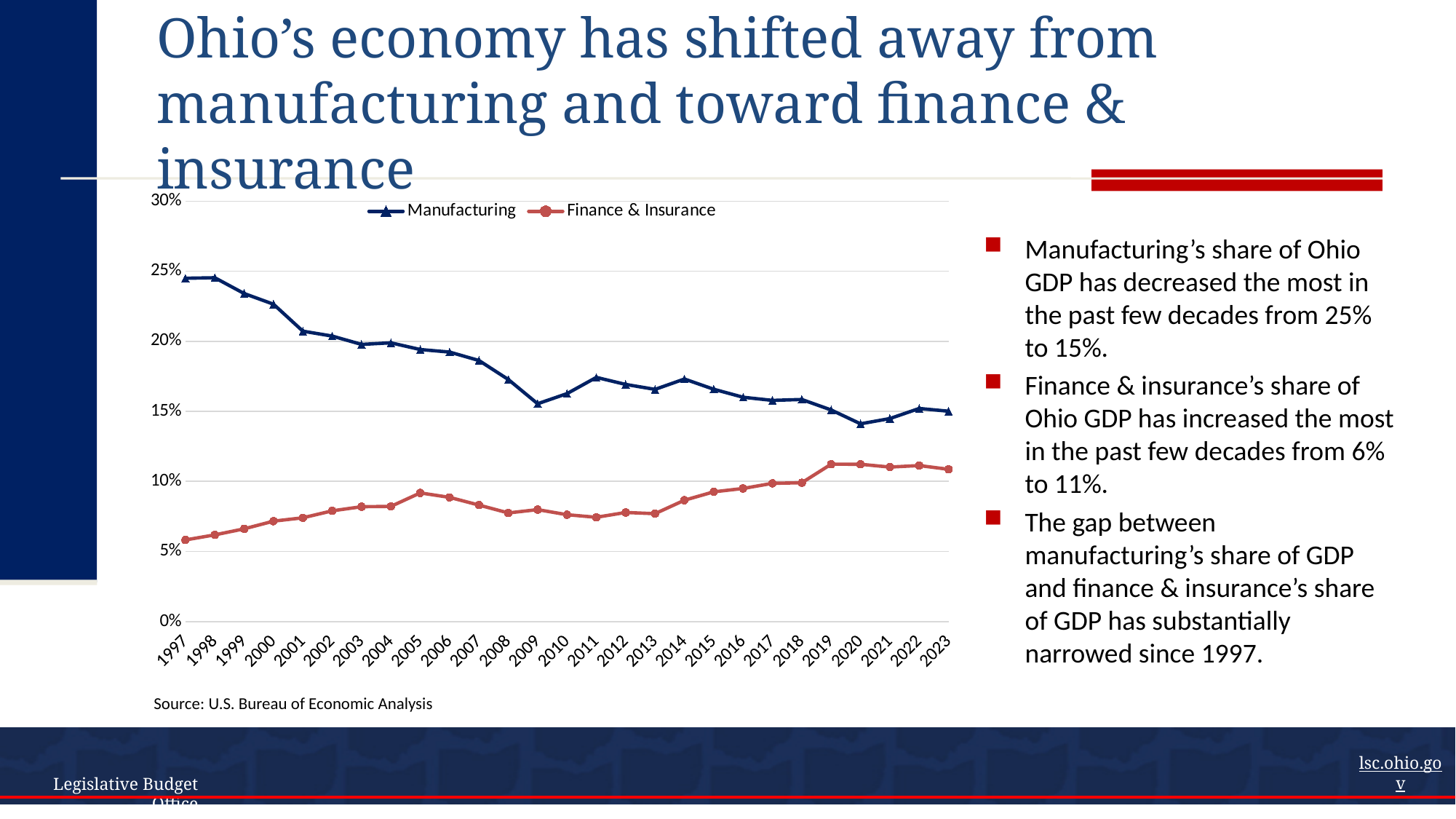
Does the Finance & Insurance line rise or fall overall from 1997 to 2023? Rise Is the Manufacturing value for 1997 greater or less than 20%? greater What kind of chart is shown on the slide? Line chart In which year is the Manufacturing series at its lowest? 2020 How many years are plotted along the x axis of the chart? 27 How many series does the chart's legend list? 2 Is the Finance & Insurance value for 1997 greater or less than 10%? less In 2023, which series has the larger value, Manufacturing or Finance & Insurance? Manufacturing Is the Manufacturing value for 2023 greater or less than 20%? less Which two series are listed in the chart's legend? Manufacturing and Finance & Insurance Does the Manufacturing line rise or fall overall from 1997 to 2023? Fall